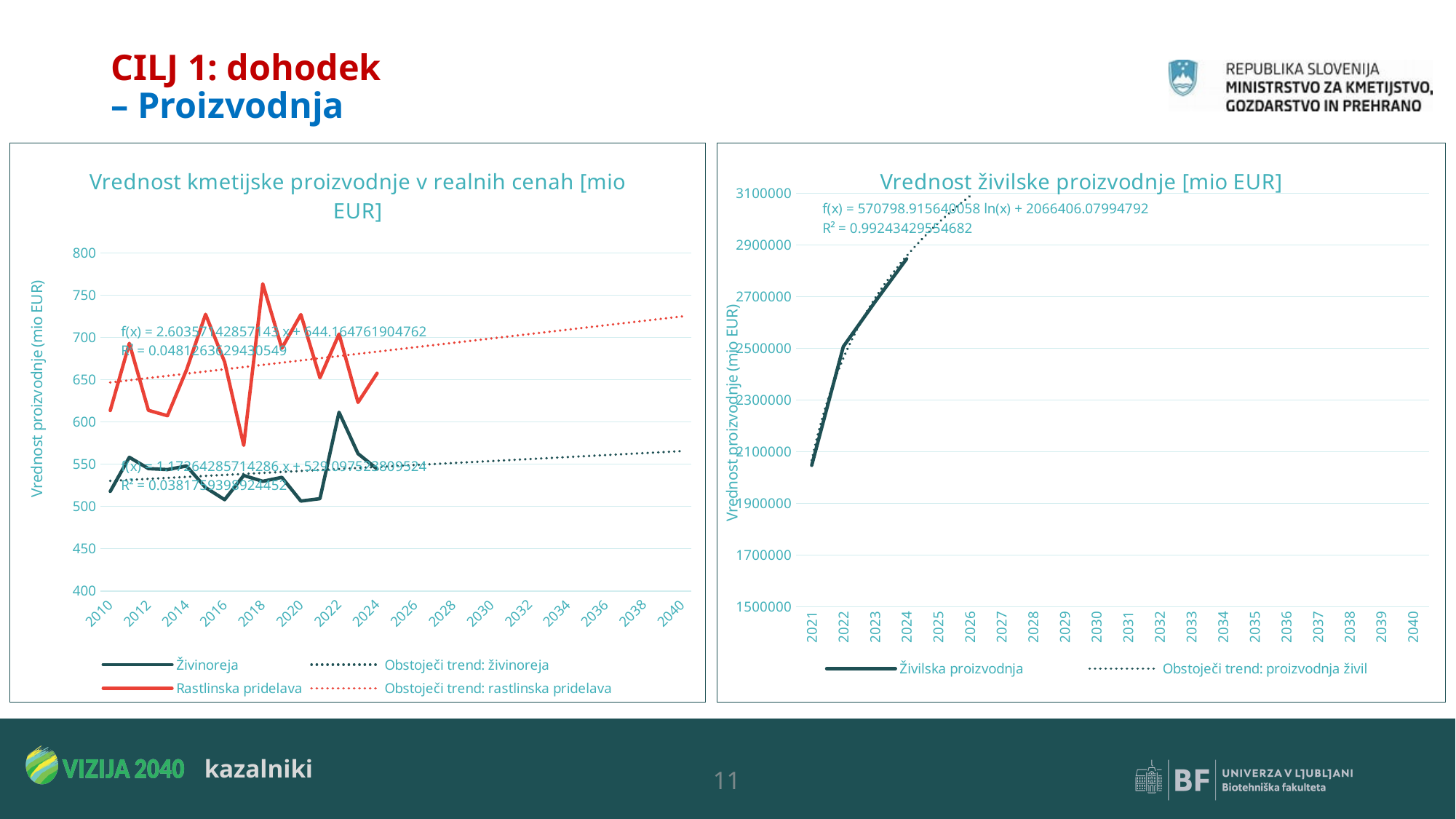
In the left chart, 'Vrednost kmetijske proizvodnje v realnih cenah [mio EUR]', is the value for Rastlinska pridelava in 2018 greater or less than 750? greater In the left chart, 'Vrednost kmetijske proizvodnje v realnih cenah [mio EUR]', is the value for Živinoreja in 2022 greater or less than 600? greater In the left chart, 'Vrednost kmetijske proizvodnje v realnih cenah [mio EUR]', which series is higher in 2018: Živinoreja or Rastlinska pridelava? Rastlinska pridelava In the right chart, 'Vrednost živilske proizvodnje [mio EUR]', does the Živilska proizvodnja line rise or fall from 2021 to 2024? rise What kind of chart is the left chart, 'Vrednost kmetijske proizvodnje v realnih cenah [mio EUR]'? line chart What kind of chart is the right chart, 'Vrednost živilske proizvodnje [mio EUR]'? line chart How many entries does the legend of the right chart, 'Vrednost živilske proizvodnje [mio EUR]', list? 2 In the left chart, 'Vrednost kmetijske proizvodnje v realnih cenah [mio EUR]', in which year does Živinoreja reach its highest value? 2022 How many entries does the legend of the left chart, 'Vrednost kmetijske proizvodnje v realnih cenah [mio EUR]', list? 4 In the left chart, 'Vrednost kmetijske proizvodnje v realnih cenah [mio EUR]', in which year does Rastlinska pridelava reach its lowest value? 2017 In the left chart, 'Vrednost kmetijske proizvodnje v realnih cenah [mio EUR]', in which year does Rastlinska pridelava reach its highest value? 2018 In the right chart, 'Vrednost živilske proizvodnje [mio EUR]', is the value for Živilska proizvodnja in 2021 greater or less than 2100000? less